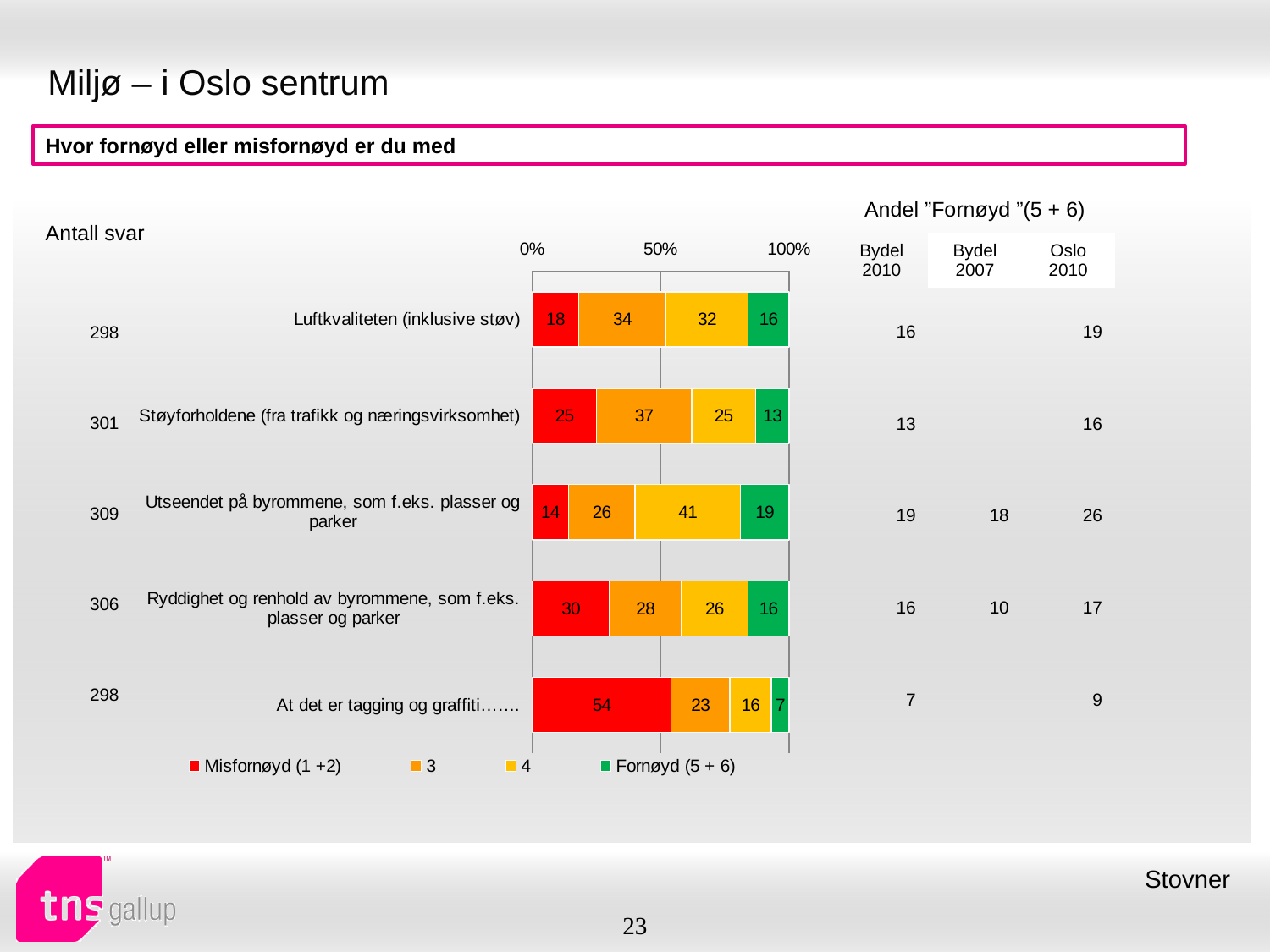
What kind of chart is shown on the slide? Stacked bar chart How many series does the legend list? 4 What is the total of the stacked bar for 'Luftkvaliteten (inklusive støv)'? 100 What is the value of series '3' for 'Støyforholdene (fra trafikk og næringsvirksomhet)'? 37 What is the 'Fornøyd (5 + 6)' value for 'Utseendet på byrommene, som f.eks. plasser og parker'? 19 How many categories are shown in the chart? 5 Which colour represents 'Fornøyd (5 + 6)' in the chart? Green Which category has the lowest 'Fornøyd (5 + 6)' value? At det er tagging og graffiti……. Which category has the highest 'Misfornøyd (1 +2)' value? At det er tagging og graffiti……. What is the difference between the 'Misfornøyd (1 +2)' values for 'At det er tagging og graffiti…….' and 'Ryddighet og renhold av byrommene, som f.eks. plasser og parker'? 24 What percentage of respondents are 'Misfornøyd (1 +2)' with 'Luftkvaliteten (inklusive støv)'? 18 Which has a larger value for series '4': 'Utseendet på byrommene, som f.eks. plasser og parker' or 'Luftkvaliteten (inklusive støv)'? Utseendet på byrommene, som f.eks. plasser og parker